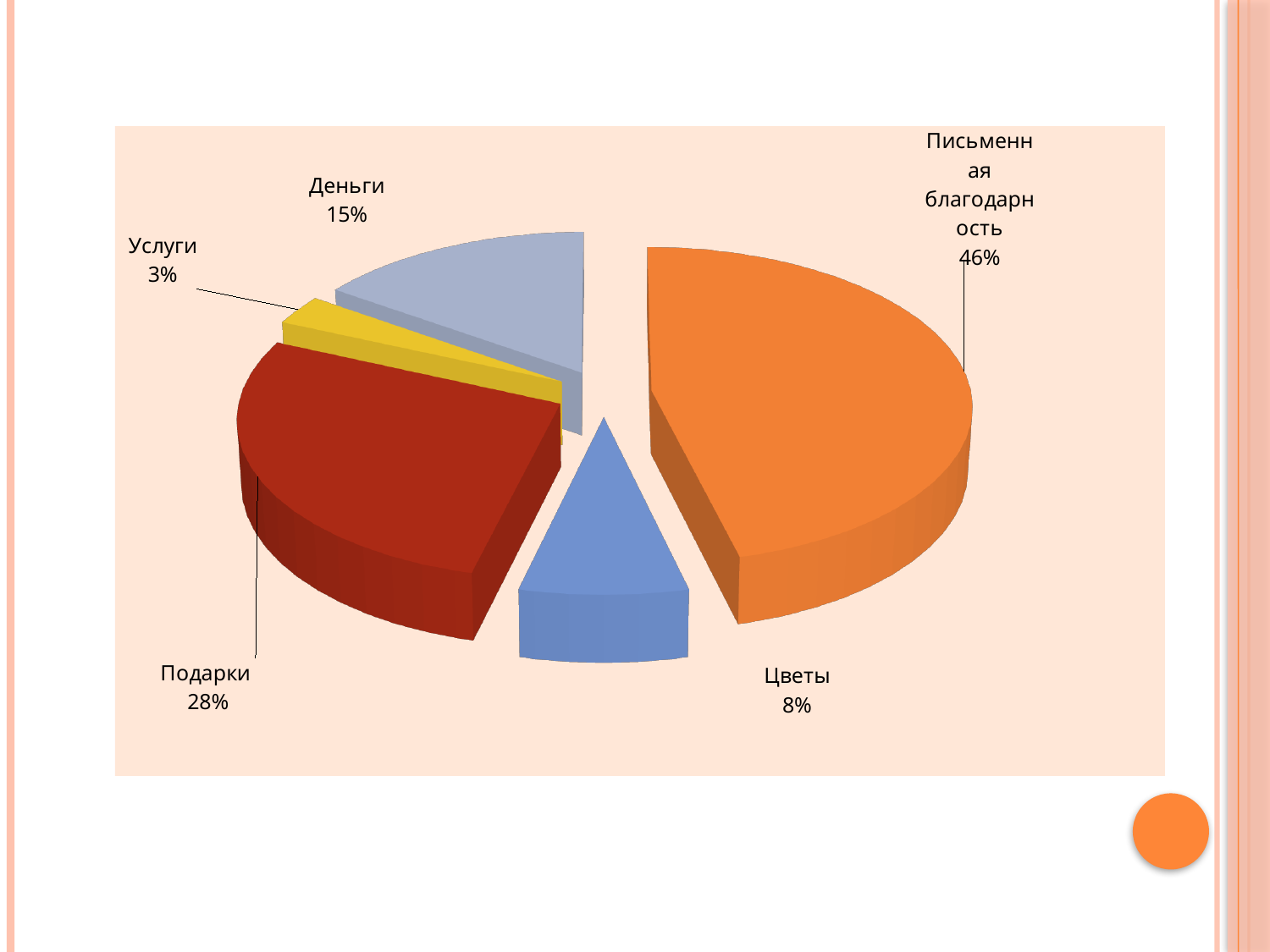
Which category has the largest share of the pie? Письменная благодарность Which is larger, the share for Деньги or the share for Цветы? Деньги How many slices does the pie chart have? 5 What kind of chart is shown on the slide? pie chart What share of the pie does Подарки have? 28% What share of the pie does Услуги have? 3% What share of the pie does Письменная благодарность have? 46% What colour is the slice for Подарки? red Which category has the smallest share of the pie? Услуги What is the difference in percentage points between Письменная благодарность and Подарки? 18